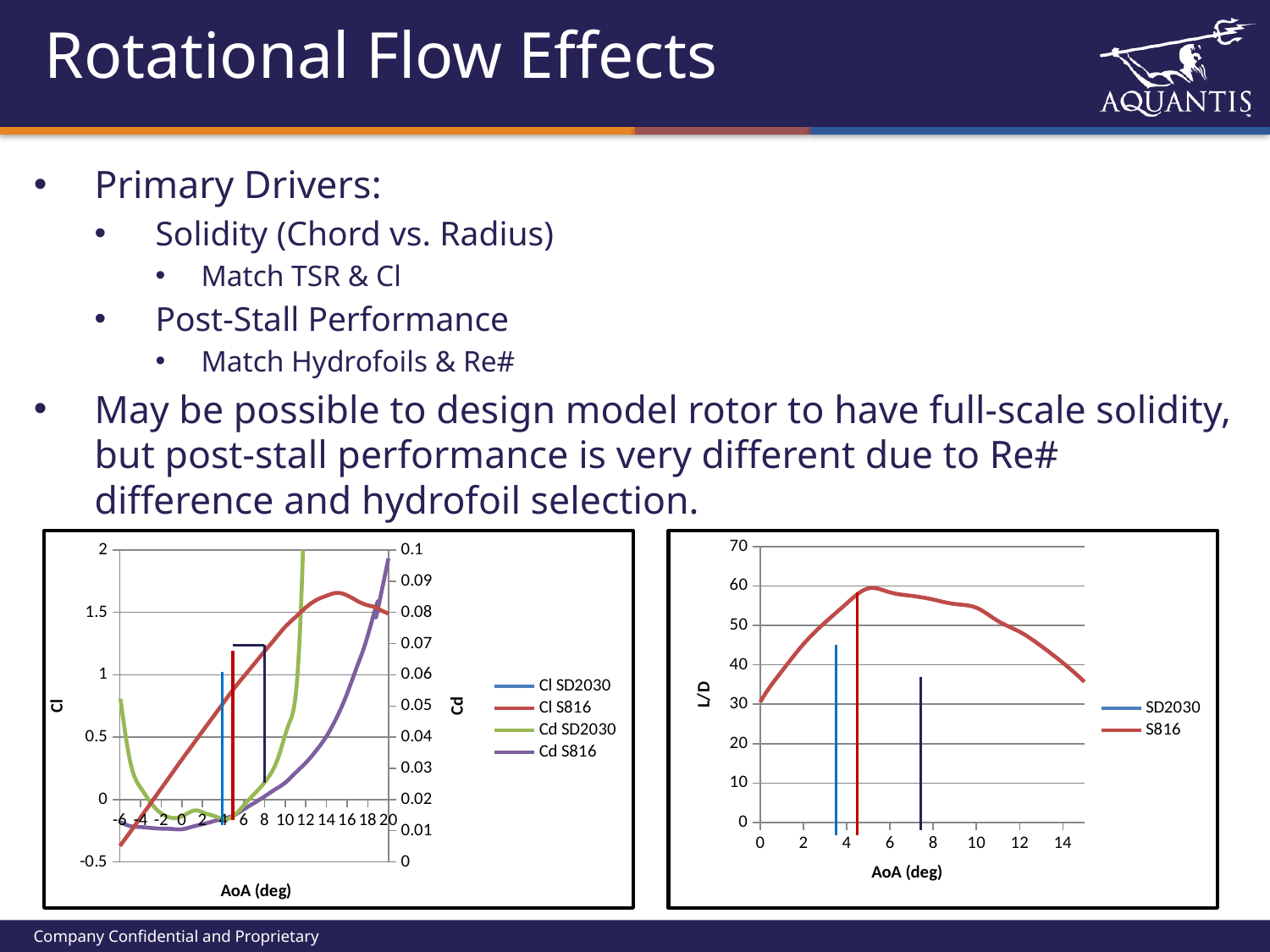
How many series does the legend of the left chart list? 4 What is the y-axis title of the right chart? L/D How many series does the legend of the right chart list? 2 In the right chart, is the peak S816 L/D value greater or less than 50? greater In the right chart, does the S816 L/D line rise or fall as AoA increases from 0 to 4 degrees? rise What kind of chart is the chart on the left of the slide? line chart In the right chart, does the S816 L/D line rise or fall as AoA increases from 6 to 14 degrees? fall What kind of chart is the chart on the right of the slide? line chart In the left chart, is the Cl S816 value at AoA 14 greater or less than 1.5? greater In the right chart, is the S816 L/D value at AoA 0 greater or less than 40? less What is the x-axis title of the right chart? AoA (deg) In the left chart, does the Cl S816 line rise or fall as AoA increases from -6 to 12 degrees? rise